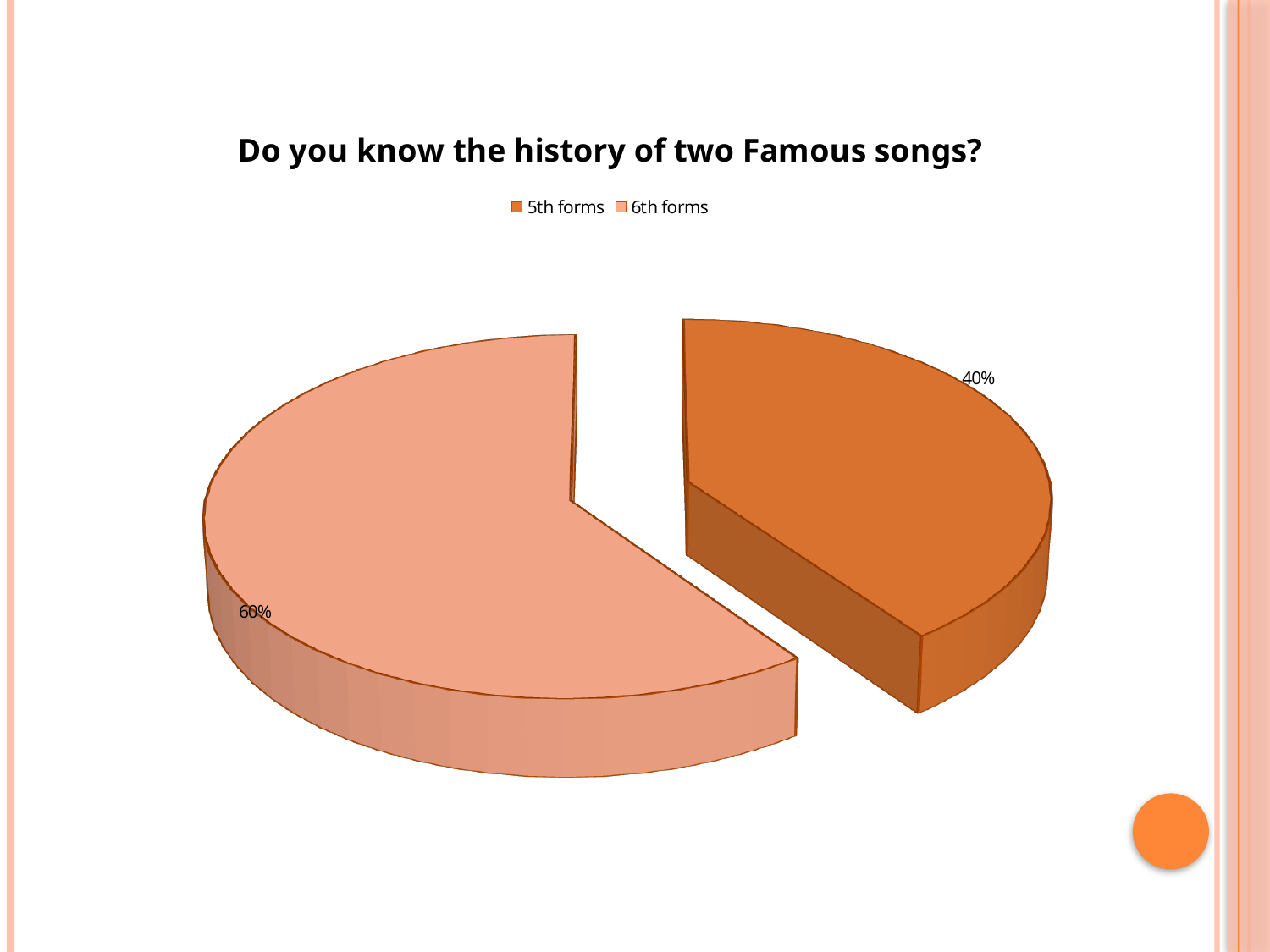
How many entries does the legend list? 2 What share of the pie does 6th forms have? 60% Which slice is larger, 5th forms or 6th forms? 6th forms What kind of chart is shown on the slide? Pie chart Which category has the smallest slice of the pie? 5th forms Which category is shown in the darker orange colour? 5th forms What is the title of the chart? Do you know the history of two Famous songs? Which category has the largest slice of the pie? 6th forms What is the difference in percentage points between the 6th forms slice and the 5th forms slice? 20% How many categories does the pie chart show? 2 What share of the pie does 5th forms have? 40%